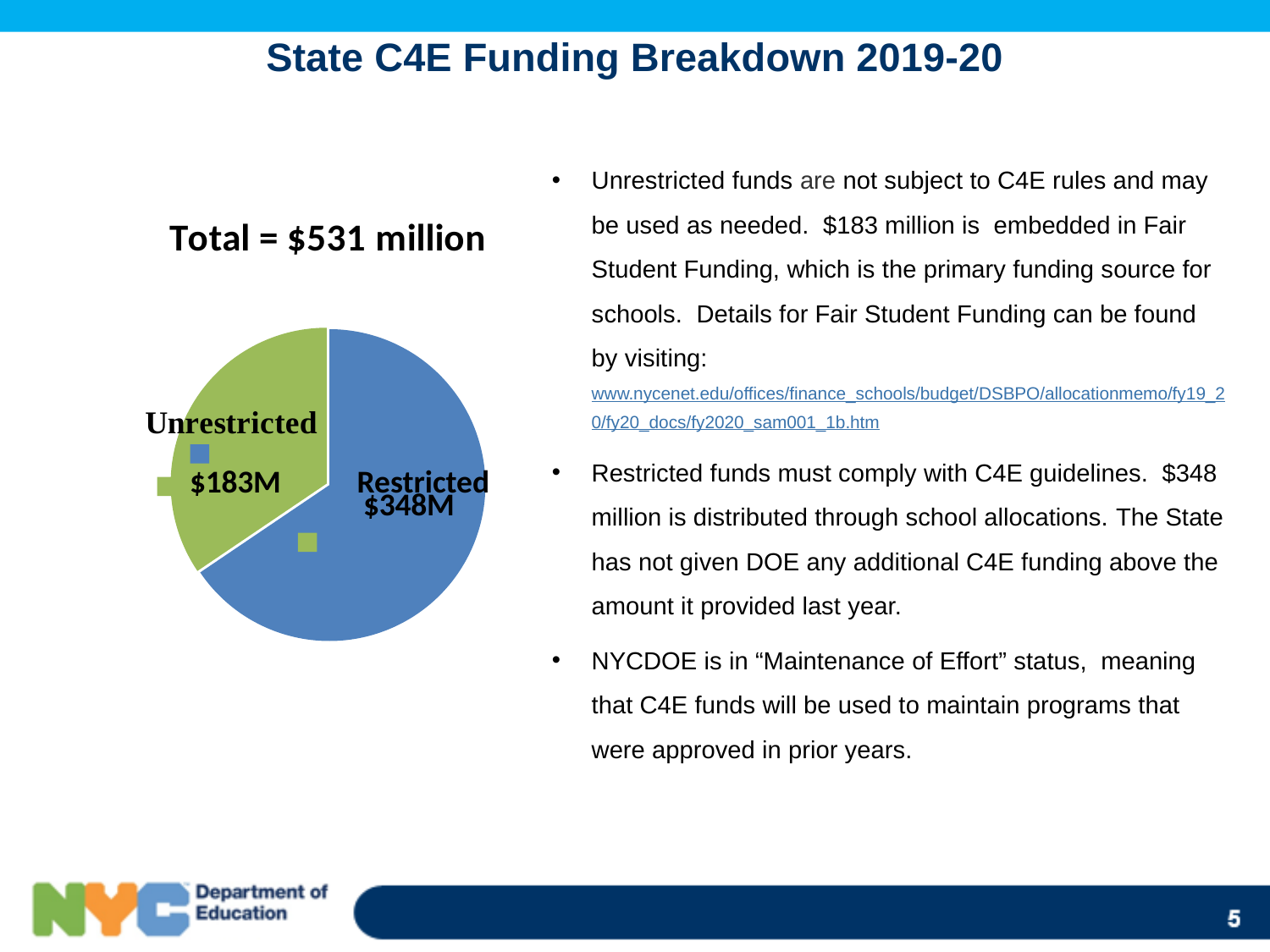
What total is stated above the pie chart? $531 million Which slice of the pie chart is the largest? Restricted How many slices does the pie chart have? 2 What is the value of the Unrestricted slice in the pie chart? $183M What is the difference between the Restricted and Unrestricted values in the pie chart? $165M What colour is the Unrestricted slice of the pie chart? Green What colour is the Restricted slice of the pie chart? Blue Which is larger, the Restricted slice or the Unrestricted slice? Restricted What type of chart is shown on the slide? Pie chart Which slice of the pie chart is the smallest? Unrestricted What is the value of the Restricted slice in the pie chart? $348M What share of the total does the Restricted slice represent? 65.5%